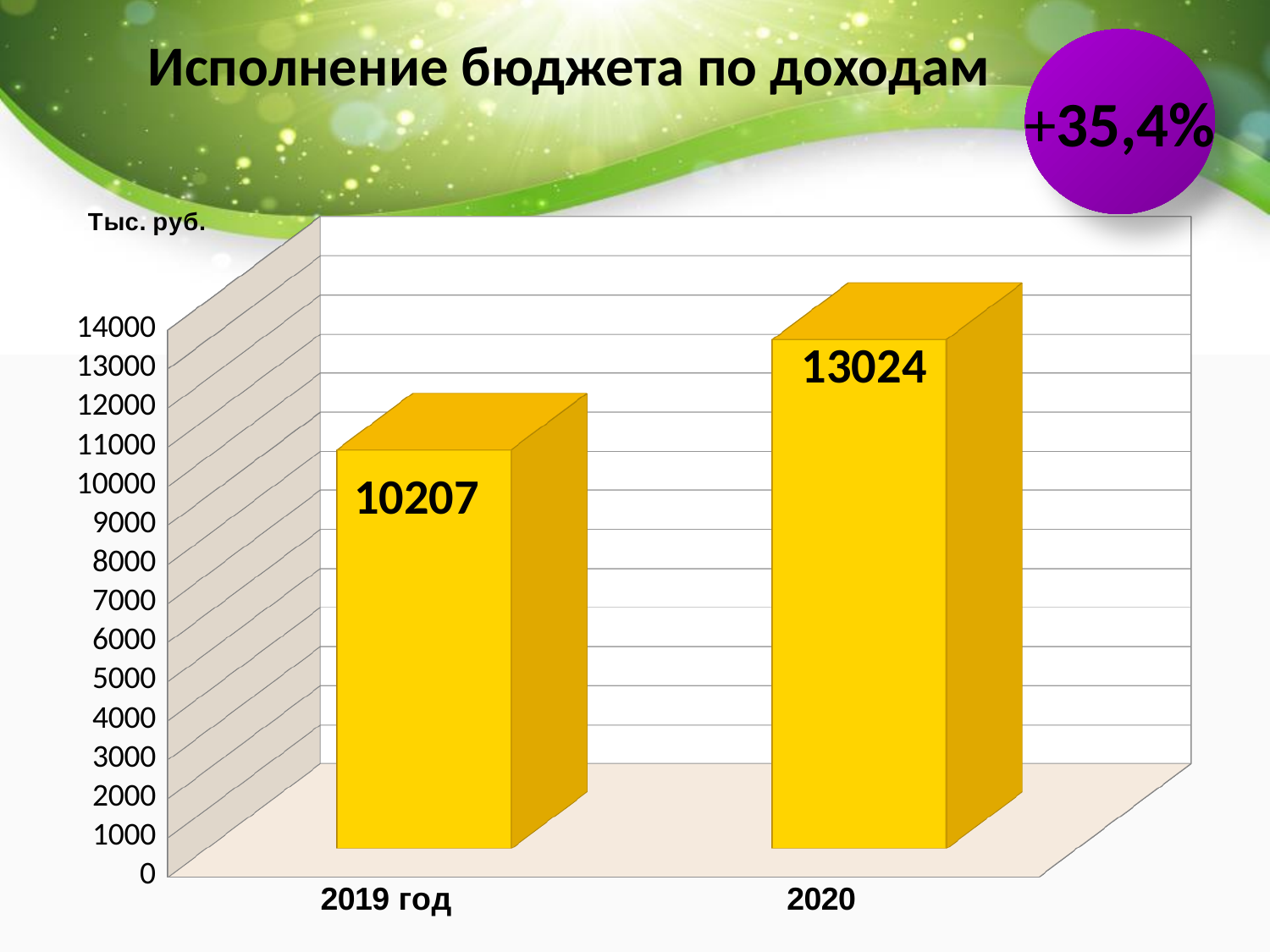
Which category has the lowest value? 2019 год What kind of chart is shown on the slide? bar chart What is the value for 2019 год? 10207 What is the difference between the values for 2020 and 2019 год? 2817 What is the title of the chart? Исполнение бюджета по доходам Do the values rise or fall from 2019 год to 2020? rise Which is larger, the value for 2019 год or the value for 2020? 2020 Is the value for 2019 год greater or less than 10000? greater How many categories are shown on the chart? 2 What is the value for 2020? 13024 Is the value for 2020 greater or less than 14000? less Which category has the highest value? 2020